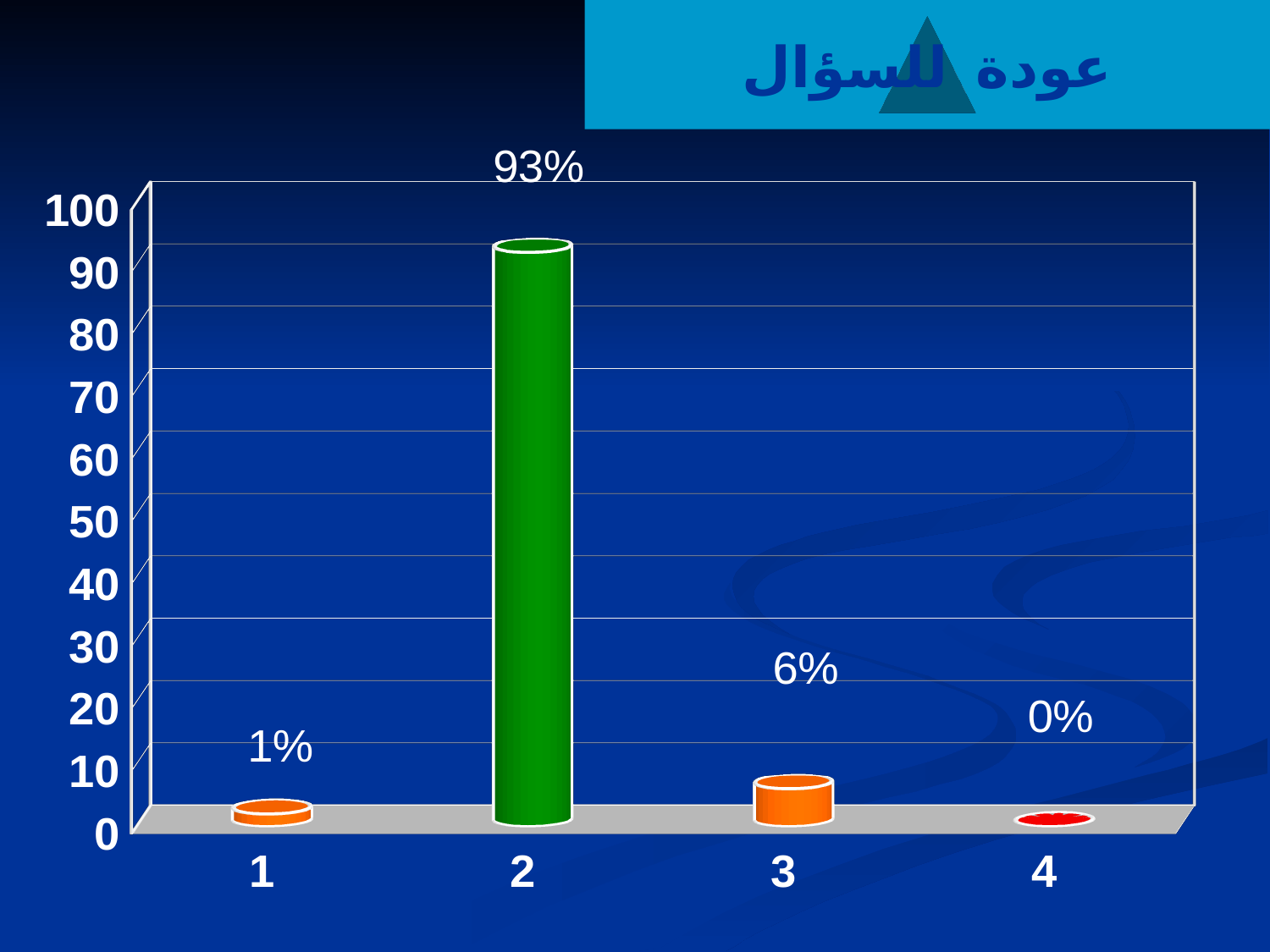
Which category has the highest value? 2 What is the value for category 4? 0% Which is larger, the value for category 3 or the value for category 1? 3 What is the value for category 3? 6% Which category has the lowest value? 4 Is the value for category 2 greater or less than 90? greater How many categories are shown on the x axis? 4 What is the value for category 2? 93% What kind of chart is shown on the slide? bar chart What is the value for category 1? 1% What colour is the bar for category 2? green What is the difference between the values for category 2 and category 3? 87%